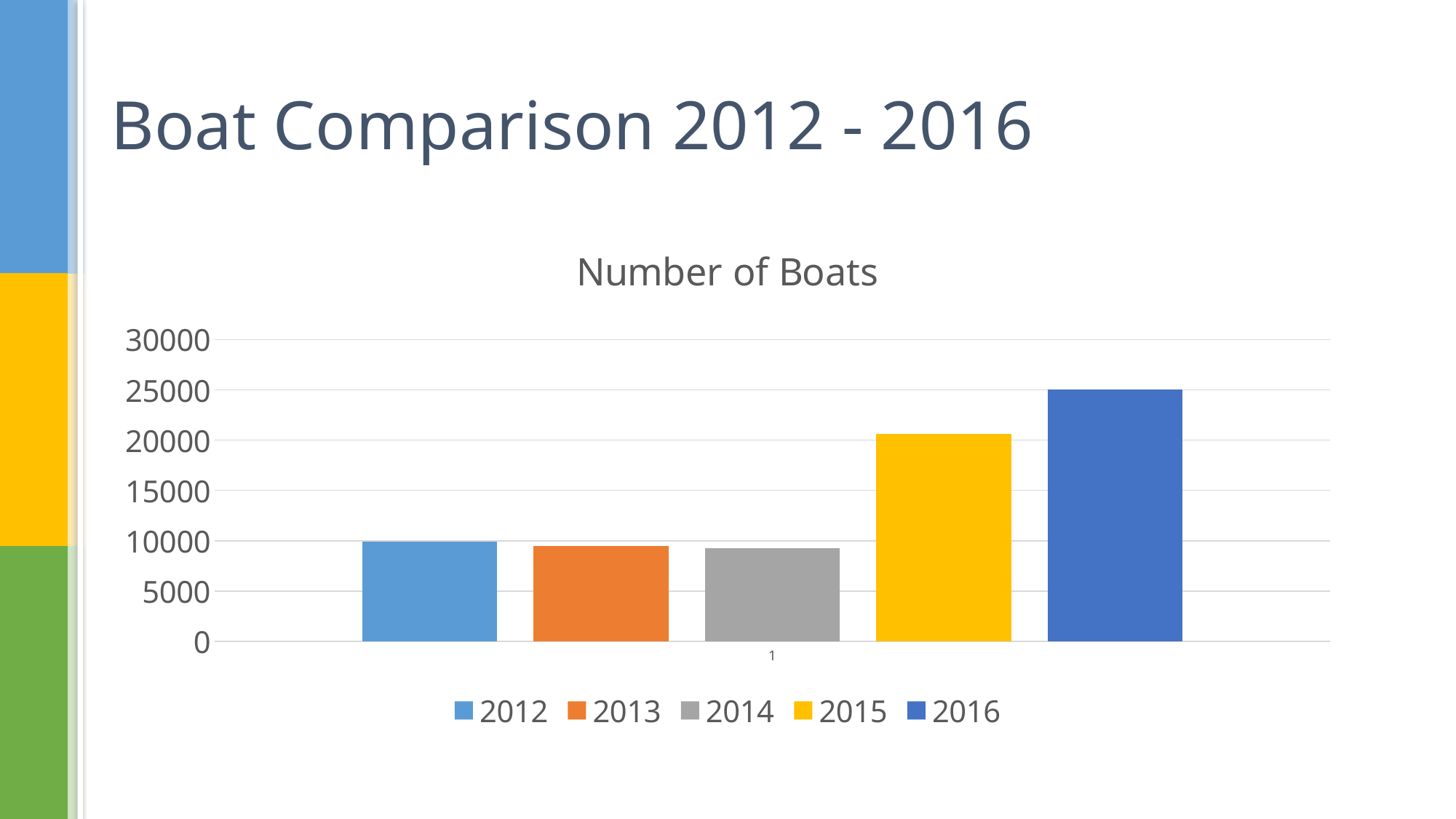
What kind of chart is shown on the slide? bar chart Is the value for 2013 greater or less than 10000? less Which is larger, the value for 2015 or the value for 2016? 2016 Which is larger, the value for 2012 or the value for 2015? 2015 Is the value for 2016 greater or less than 20000? greater Is the value for 2015 greater or less than 20000? greater What is the title of the chart? Number of Boats Which colour represents 2015 in the legend? yellow How many series does the legend list? 5 Which year has the highest number of boats? 2016